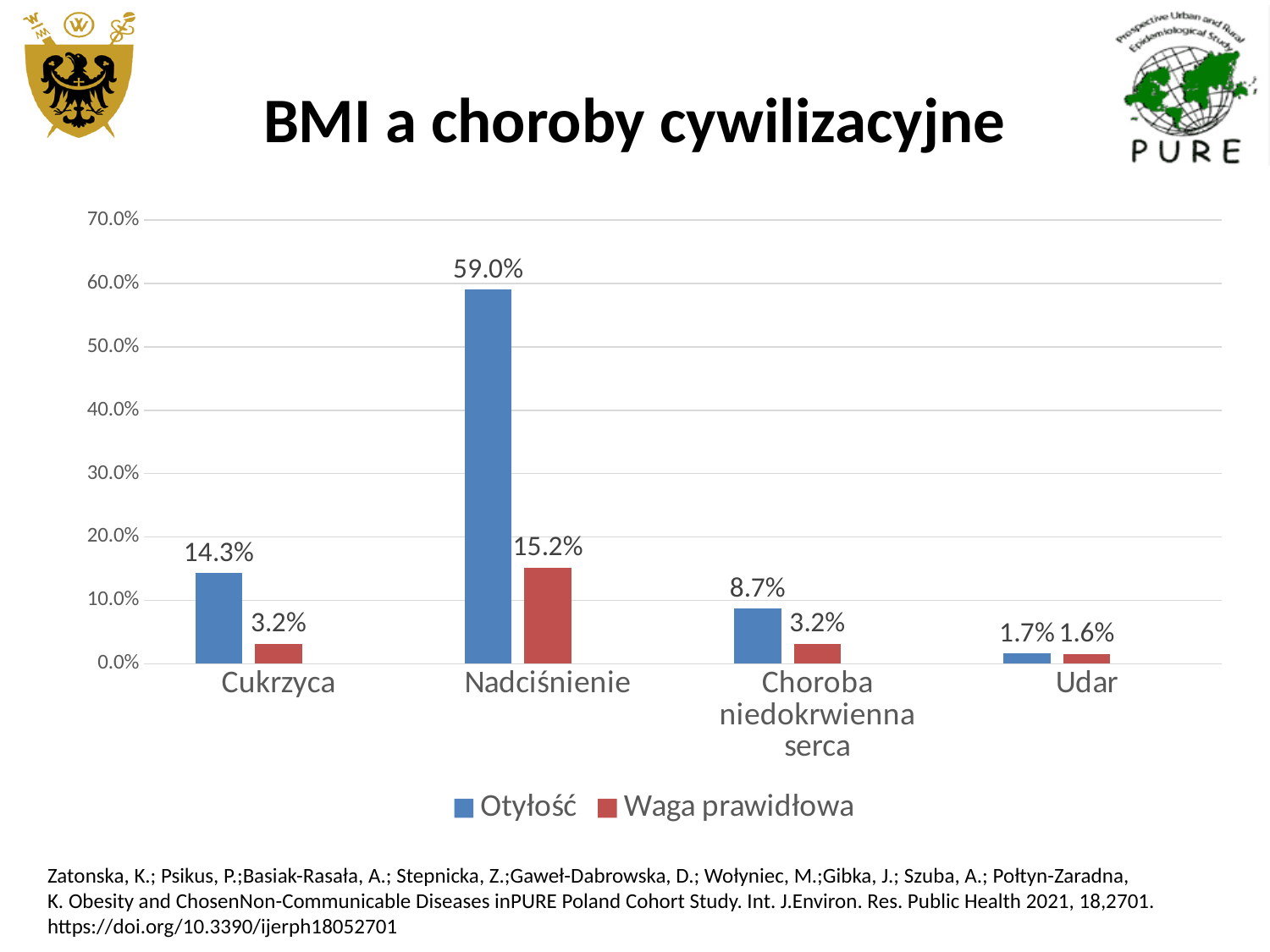
Which is larger in the Cukrzyca category: the Otyłość value or the Waga prawidłowa value? Otyłość Which category has the highest value for Otyłość? Nadciśnienie What is the value for Waga prawidłowa in the Udar category? 1.6% Which category has the lowest value for Waga prawidłowa? Udar What is the value for Otyłość in the Nadciśnienie category? 59.0% How many series does the legend list? 2 How many categories are shown on the x axis? 4 What is the value for Otyłość in the Choroba niedokrwienna serca category? 8.7% What is the title of the slide? BMI a choroby cywilizacyjne What is the difference between the Otyłość and Waga prawidłowa values in the Nadciśnienie category? 43.8% What kind of chart is shown on the slide? Bar chart What is the value for Waga prawidłowa in the Cukrzyca category? 3.2%